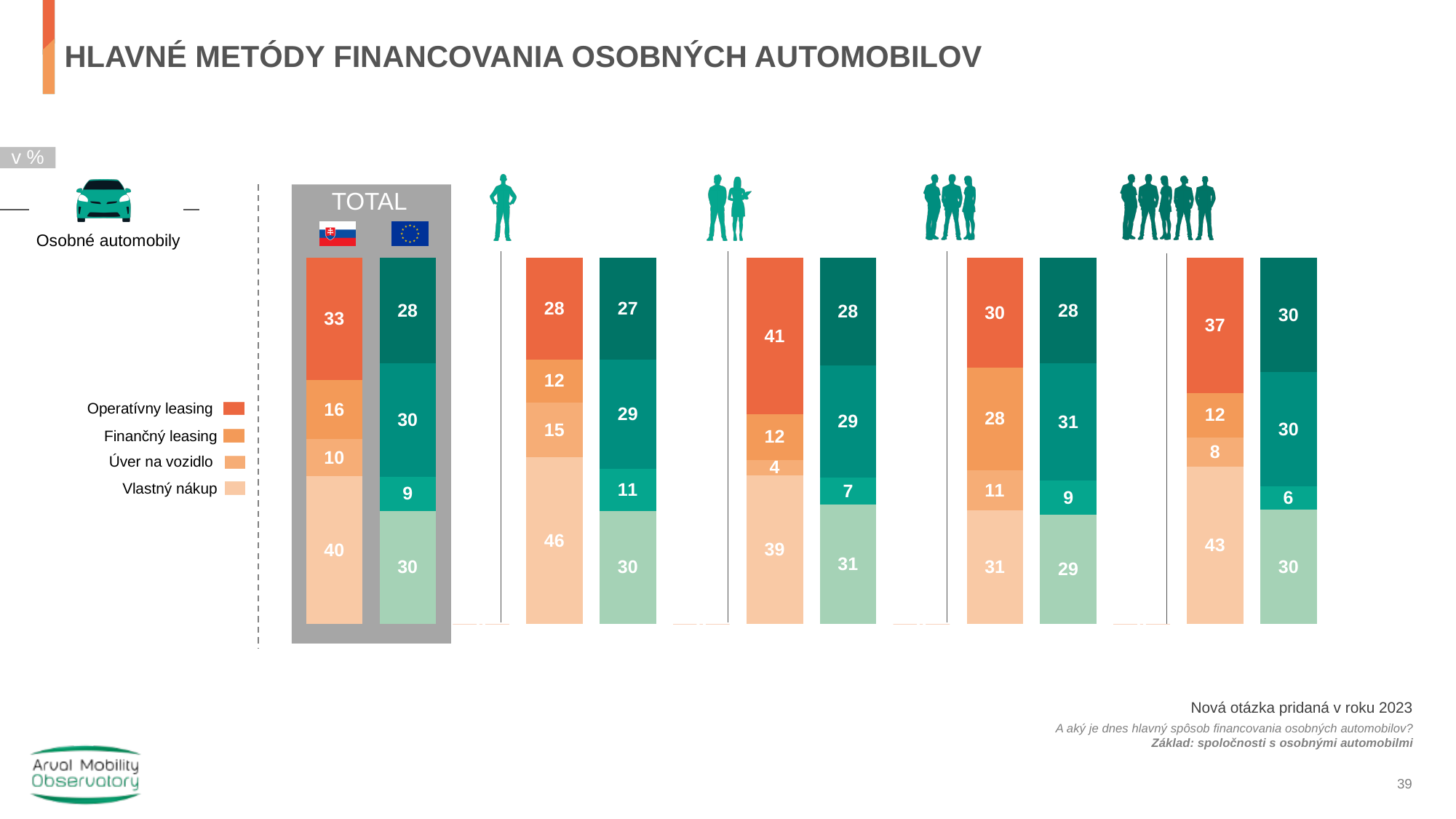
In the TOTAL section, what is the difference between the Slovak and EU values for Operatívny leasing? 5 In the TOTAL section, what is the Slovak value for Úver na vozidlo? 10 In the TOTAL section, what is the EU value for Finančný leasing? 30 In the Slovak TOTAL bar, which financing method has the largest share? Vlastný nákup What kind of chart is shown on the slide? Stacked bar chart What is the sum of the four segments in the Slovak TOTAL bar? 99 In the Slovak TOTAL bar, which financing method has the smallest share? Úver na vozidlo In the TOTAL section, what is the EU value for Vlastný nákup? 30 How many series does the legend list? 4 In the rightmost pair of bars (group with five person icons), what is the Slovak value for Operatívny leasing? 37 In the TOTAL section, what is the Slovak value for Operatívny leasing? 33 In the TOTAL section, which is larger for Vlastný nákup: the Slovak value or the EU value? Slovak value (40)